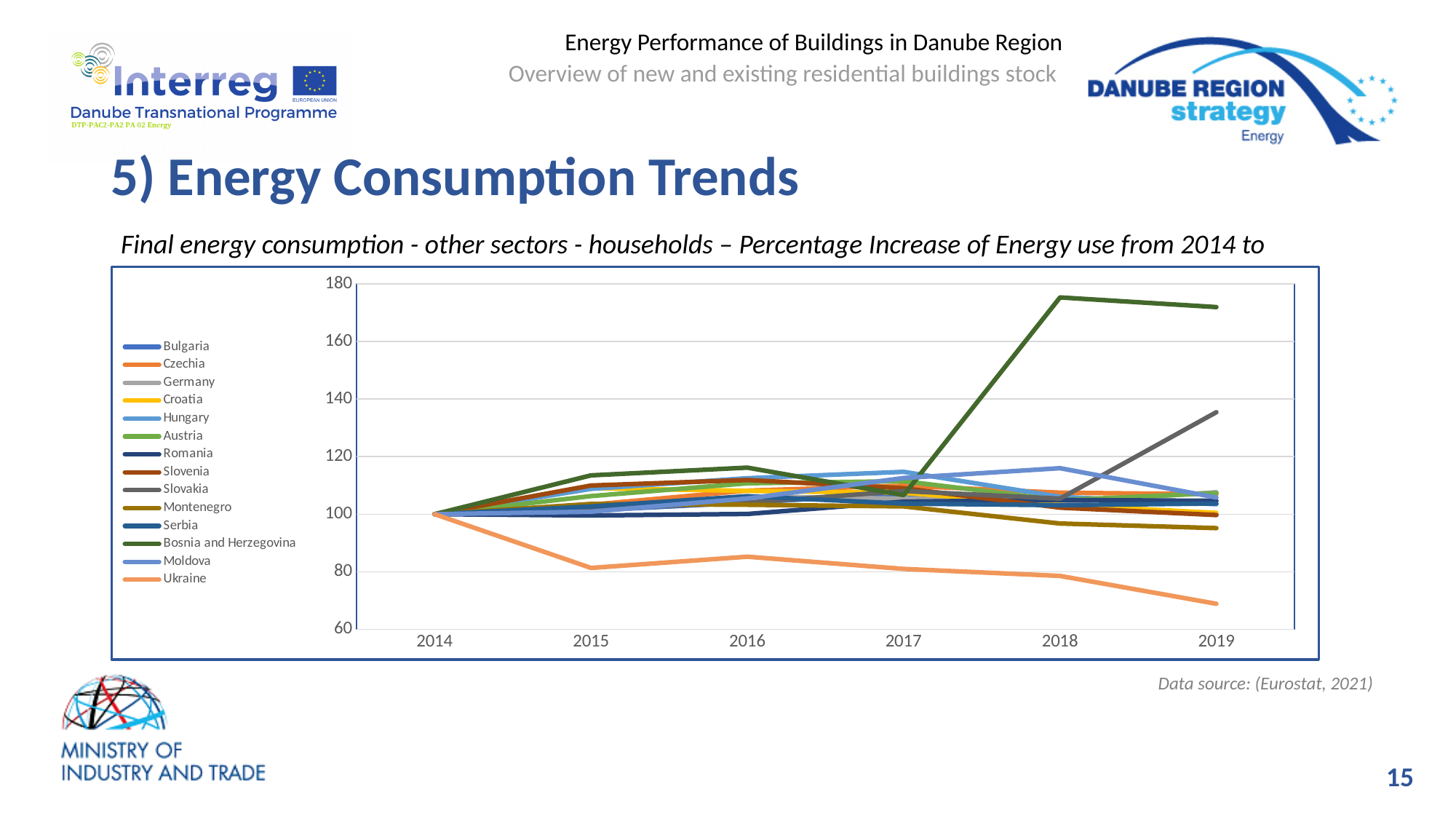
Is the value for Bosnia and Herzegovina in 2018 greater or less than 160? greater Is the value for Ukraine in 2019 greater or less than 80? less In 2019, which is higher: Bosnia and Herzegovina or Slovakia? Bosnia and Herzegovina How many series does the legend list? 14 Does the value for Ukraine rise or fall from 2014 to 2019? fall What is the value for Bulgaria in 2014? 100 Is the value for Slovakia in 2019 greater or less than 120? greater What kind of chart is shown on the slide? line chart How many years are shown along the x axis? 6 Which country has the highest value in 2019? Bosnia and Herzegovina Which country has the lowest value in 2019? Ukraine What data source is cited below the chart? Eurostat, 2021